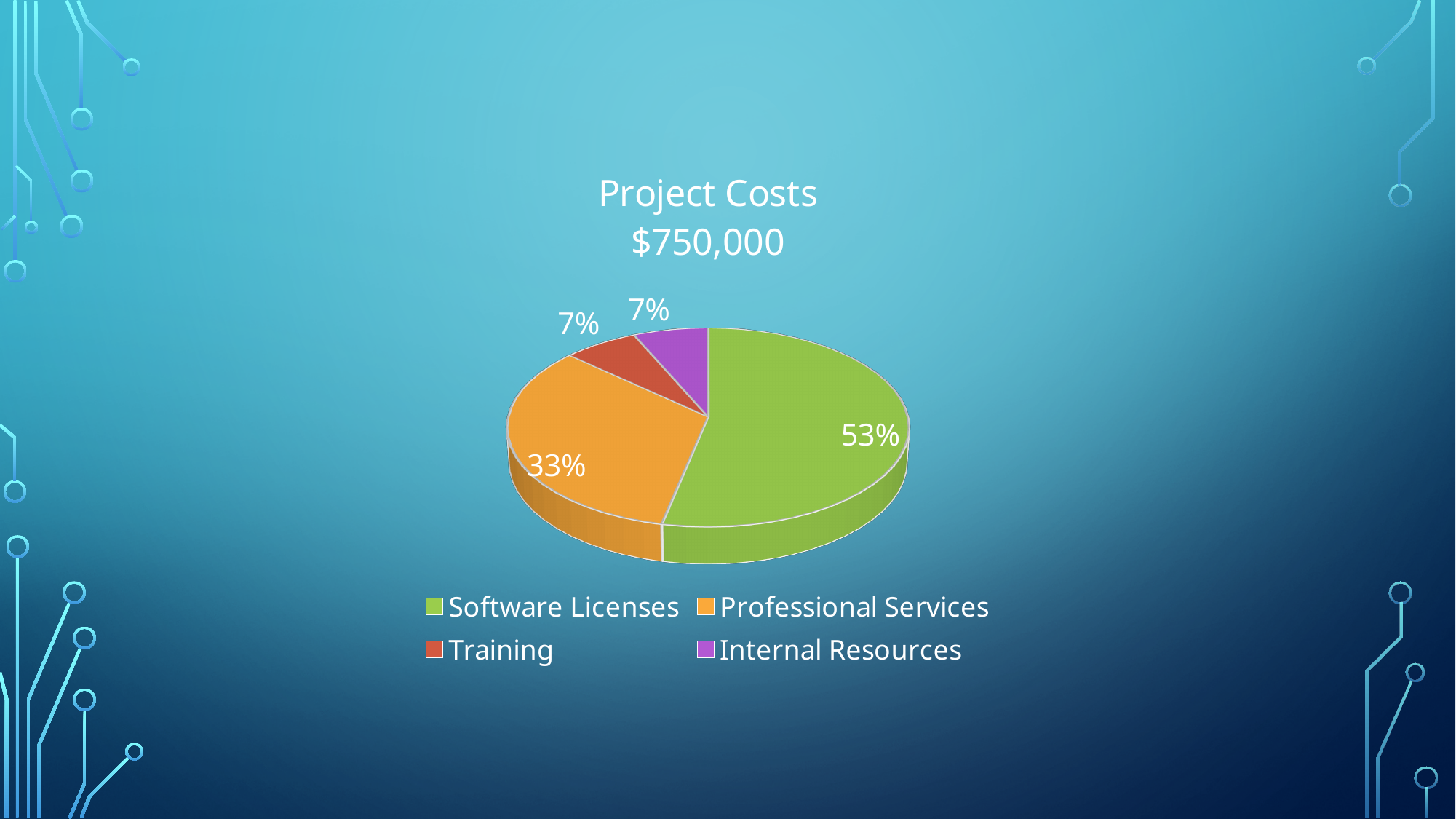
Which is larger, the share for Professional Services or the share for Training? Professional Services What share of project costs is Software Licenses? 53% What is the title of the chart? Project Costs $750,000 What share of project costs is Professional Services? 33% What is the difference in percentage points between Professional Services and Internal Resources? 26 percentage points What is the difference in percentage points between Software Licenses and Professional Services? 20 percentage points What colour is the Professional Services slice? Orange What kind of chart is shown on the slide? Pie chart Which category has the largest share of project costs? Software Licenses What share of project costs is Training? 7% How many categories does the pie chart show? 4